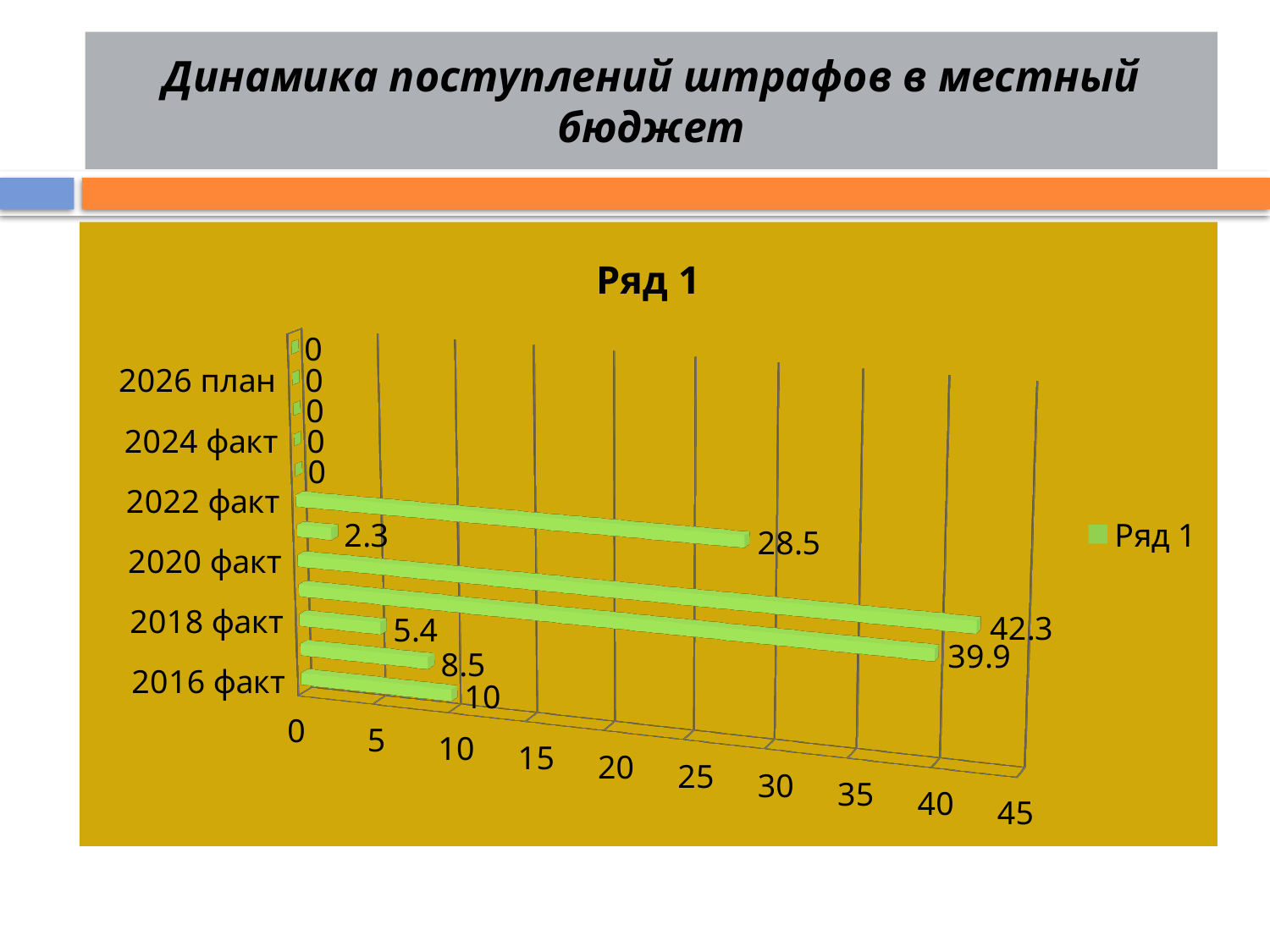
What is the value for 2026 план? 0 What kind of chart is shown on the slide? bar chart Which is larger, the value for 2016 факт or 2018 факт? 2016 факт Is the value for 2022 факт greater or less than 25? greater How many series does the legend list? 1 What is the value for 2016 факт? 10 How many bars are plotted in the chart? 12 What is the difference between the values for 2020 факт and 2022 факт? 13.8 What is the value for 2020 факт? 42.3 What is the value for 2022 факт? 28.5 What is the value for 2018 факт? 5.4 Which labelled category has the highest value? 2020 факт